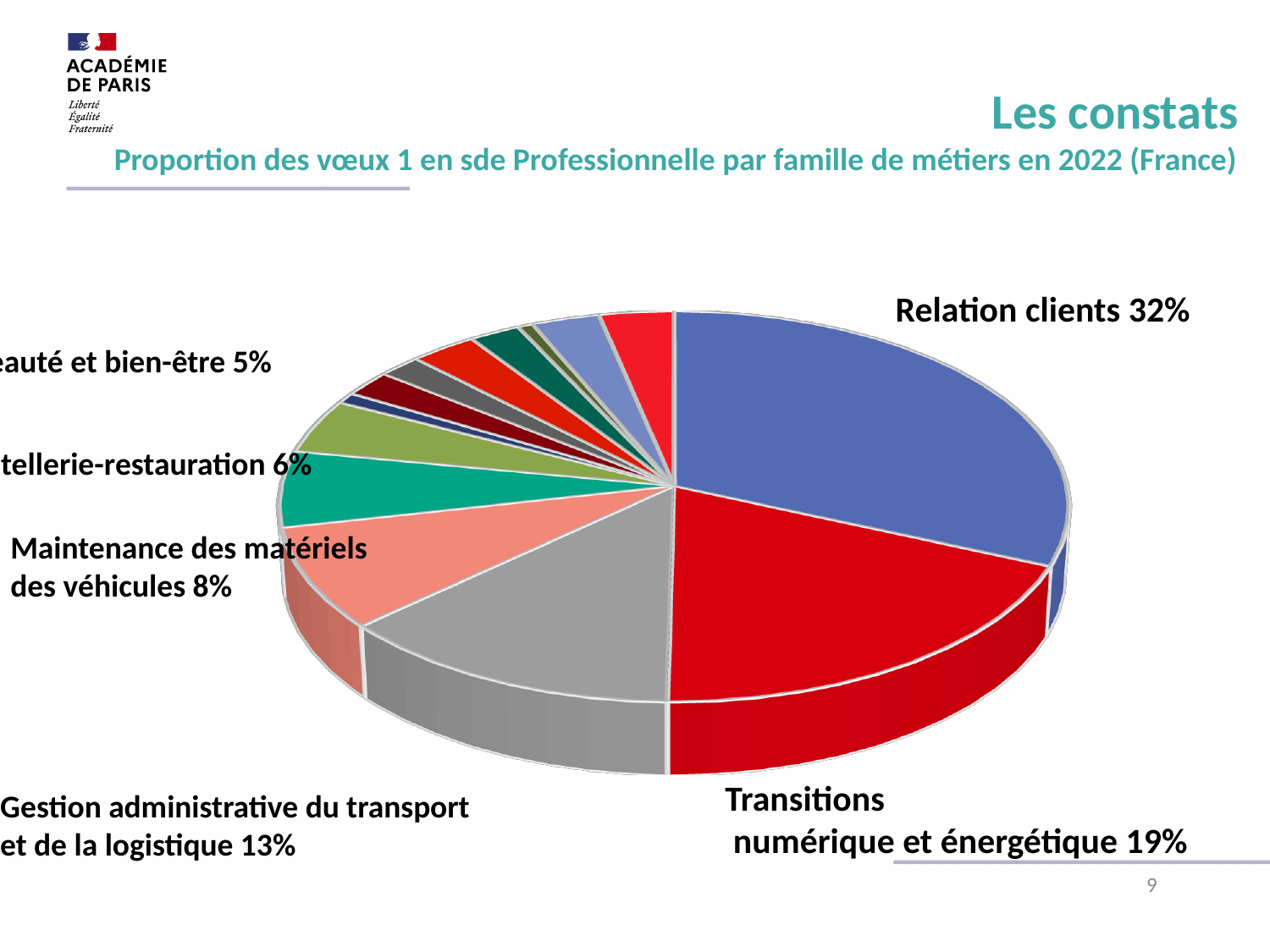
What is the title of the chart? Proportion des vœux 1 en sde Professionnelle par famille de métiers en 2022 (France) What percentage is shown for Maintenance des matériels des véhicules? 8% What percentage is shown for Transitions numérique et énergétique? 19% What kind of chart is shown on the slide? Pie chart What percentage of the pie does the Relation clients slice represent? 32% Which has a larger share: Gestion administrative du transport et de la logistique or Maintenance des matériels des véhicules? Gestion administrative du transport et de la logistique What percentage is shown for Gestion administrative du transport et de la logistique? 13% What colour is the Relation clients slice? Blue What is the difference in percentage points between Relation clients and Transitions numérique et énergétique? 13 percentage points Which has a larger share: Relation clients or Maintenance des matériels des véhicules? Relation clients Which family of trades has the largest share of the pie? Relation clients What is the difference in percentage points between Transitions numérique et énergétique and Gestion administrative du transport et de la logistique? 6 percentage points